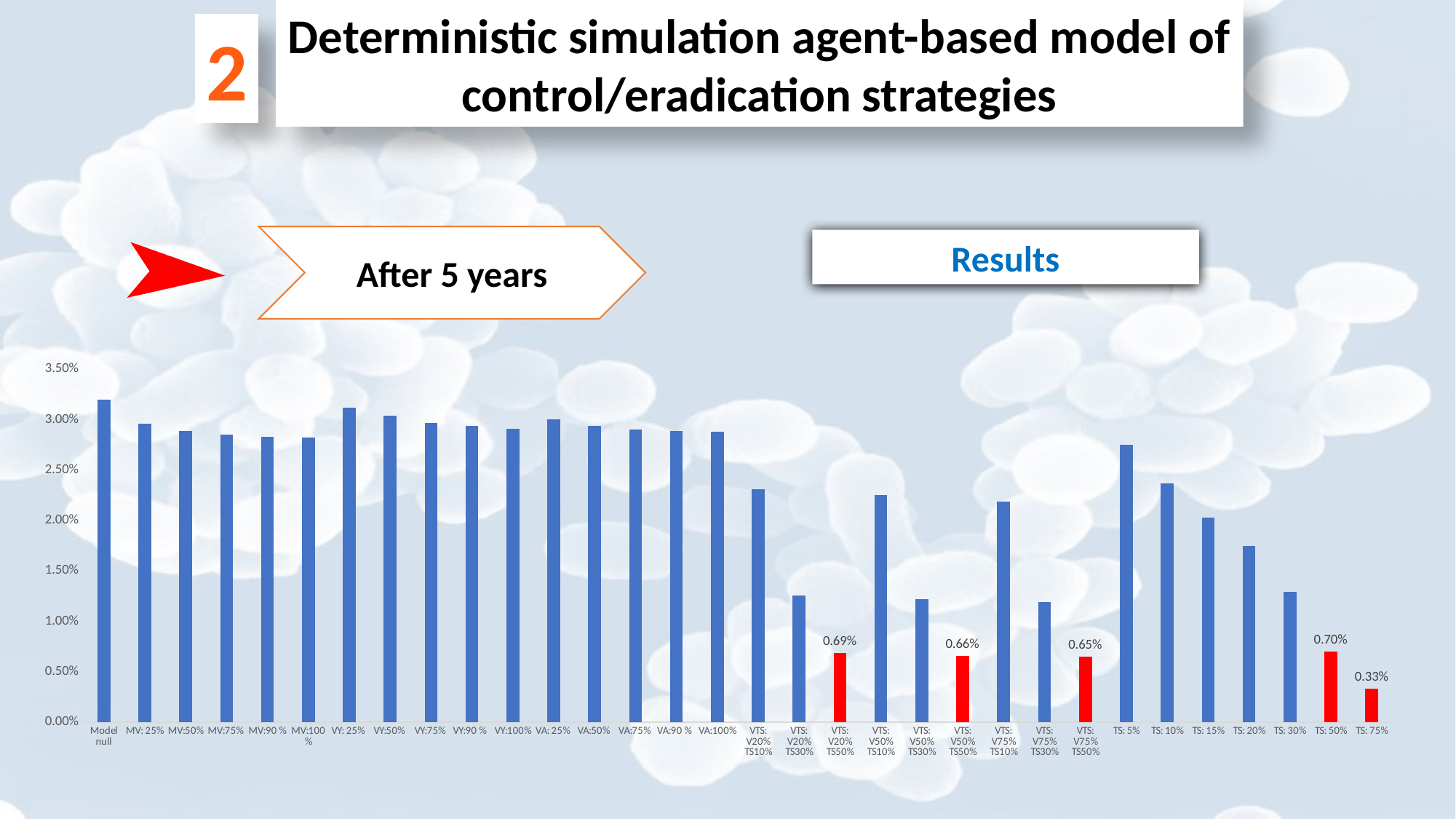
Which is larger, the value for VTS: V20% TS50% or VTS: V75% TS50%? VTS: V20% TS50% What is the value for VTS: V50% TS50%? 0.66% Which category has the lowest value? TS: 75% What kind of chart is shown on the slide? bar chart What is the difference between the values for TS: 50% and TS: 75%? 0.37% What is the value for TS: 50%? 0.70% What is the value for TS: 75%? 0.33% Is the value for Model null greater or less than 3.00%? greater How many bars are coloured red? 5 Do the values rise or fall from TS: 5% to TS: 75%? fall Is the value for TS: 30% greater or less than 1.50%? less What is the value for VTS: V20% TS50%? 0.69%